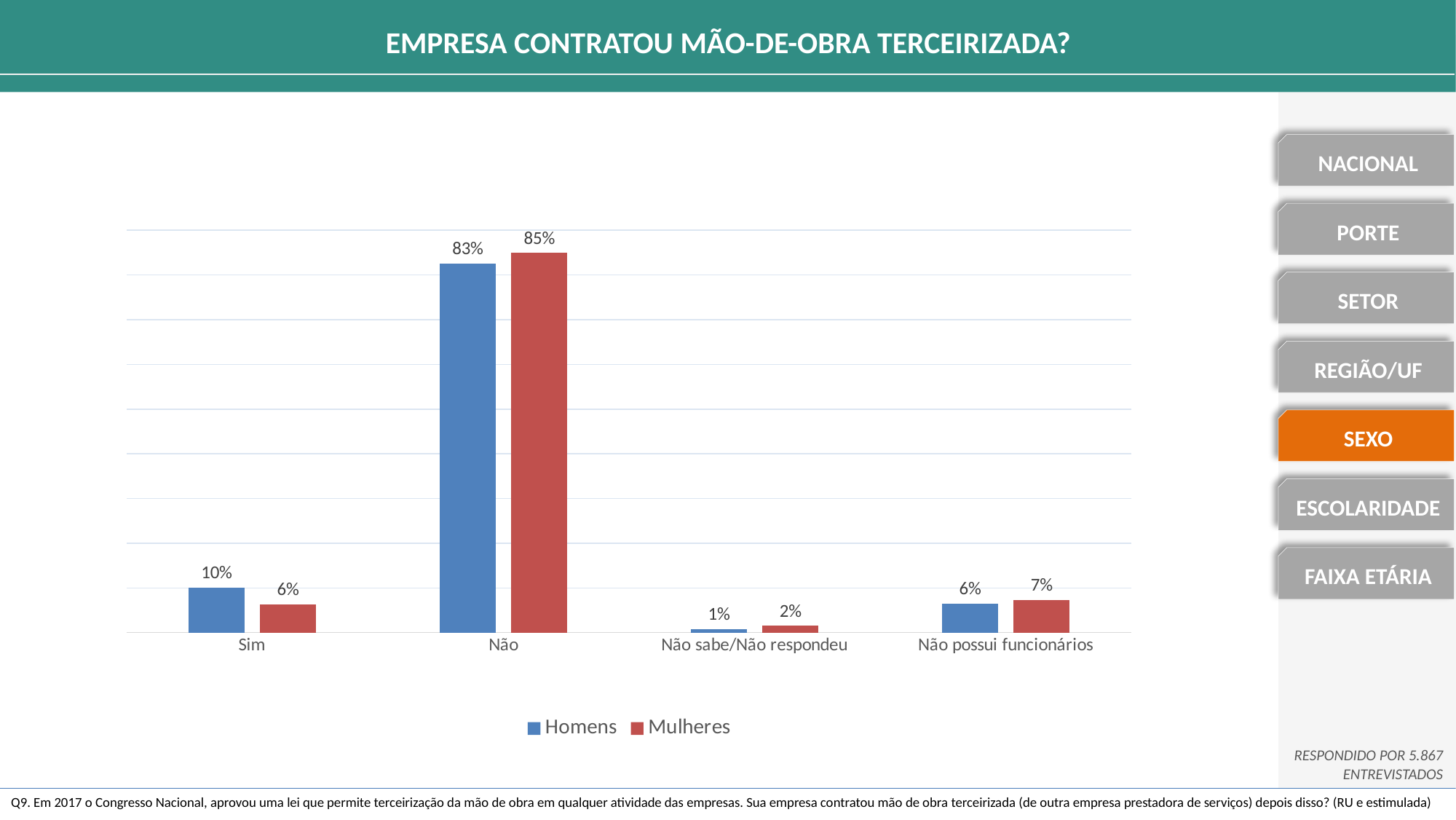
How many categories are shown on the x axis? 4 What is the difference between the Mulheres and Homens values in the Não category? 2% In the Sim category, which series has the larger value, Homens or Mulheres? Homens What kind of chart is shown on the slide? Bar chart What is the value for Homens in the Não category? 83% How many series does the legend list? 2 Which category has the lowest value for Homens? Não sabe/Não respondeu What is the value for Mulheres in the Sim category? 6% What is the difference between the Homens and Mulheres values in the Sim category? 4% Which category has the highest value for Mulheres? Não What is the value for Mulheres in the Não possui funcionários category? 7% What is the value for Homens in the Não sabe/Não respondeu category? 1%